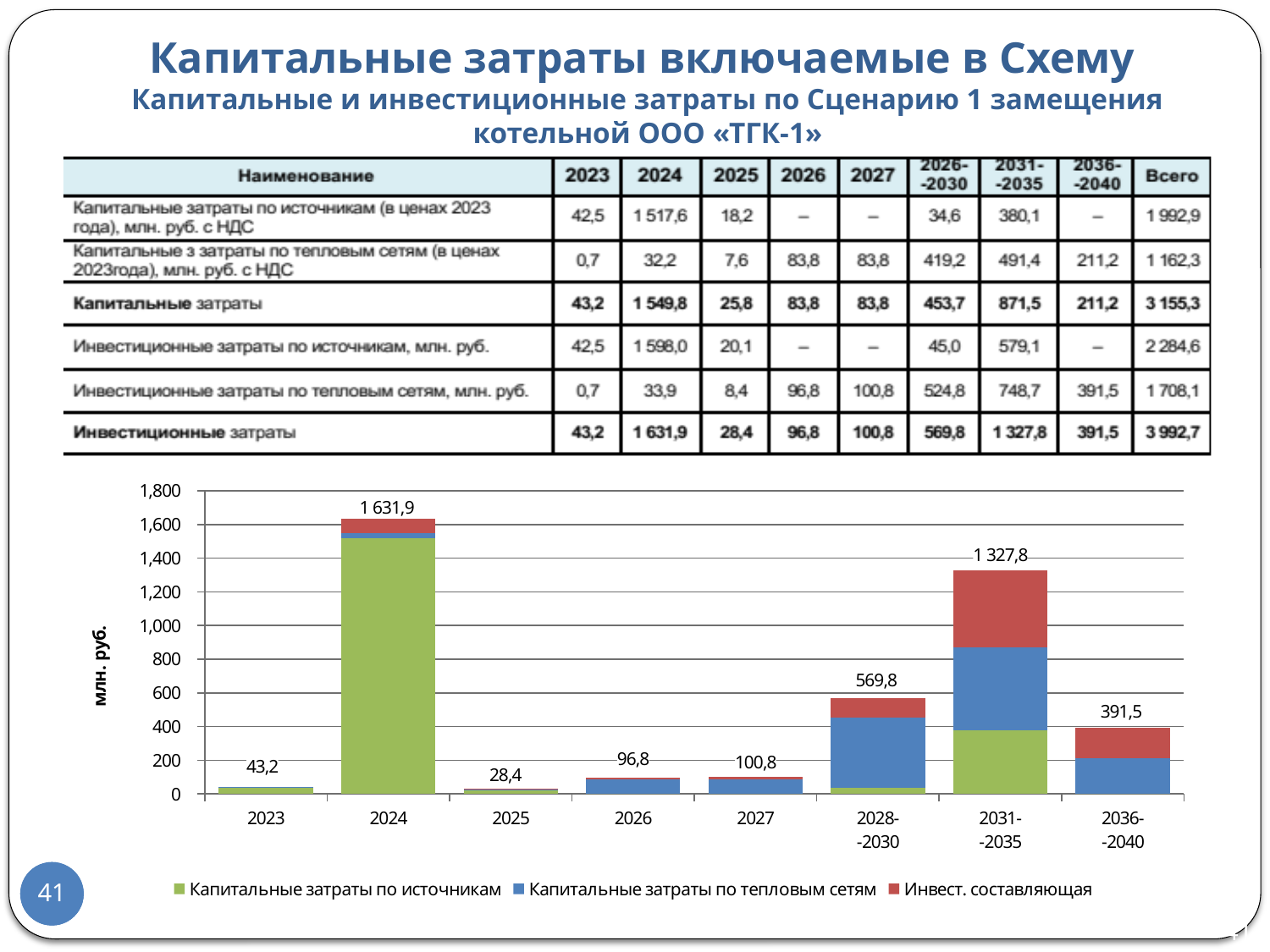
Which category has the lowest total bar? 2025 How many categories are shown on the x axis of the chart? 8 What is the total value labelled on the bar for 2036--2040? 391,5 What kind of chart is shown on the slide? stacked bar chart What is the total value labelled on the bar for 2024? 1 631,9 Which category has the highest total bar? 2024 What is the total value labelled on the bar for 2031--2035? 1 327,8 What is the difference between the total for 2024 and the total for 2031--2035? 304,1 Which is larger, the total for 2026 or the total for 2027? 2027 What is the label on the vertical axis of the chart? млн. руб. What is the total value labelled on the bar for 2028--2030? 569,8 How many series does the chart legend list? 3